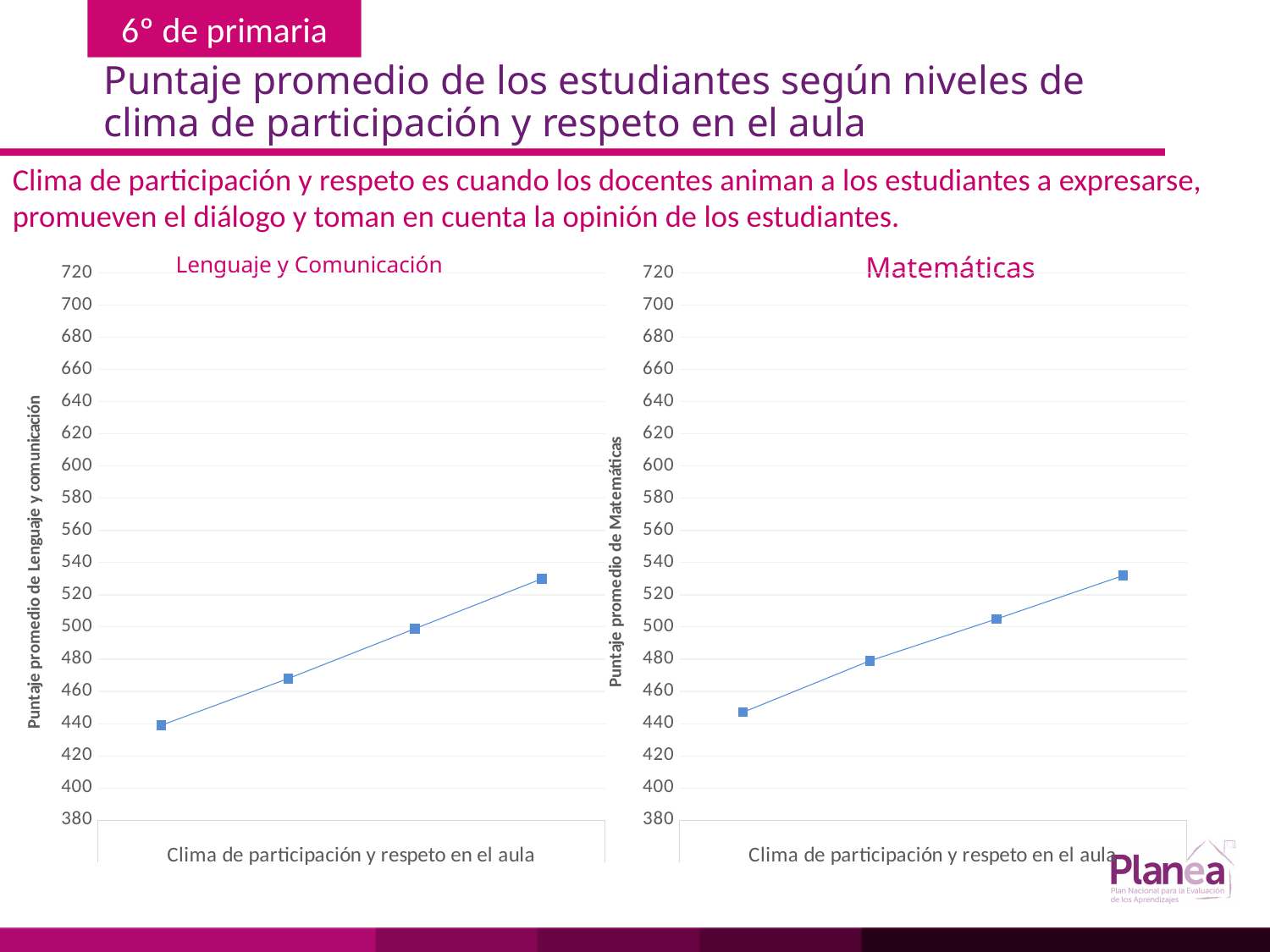
In the Matemáticas chart, is the value of the rightmost point greater or less than 520? greater In the Matemáticas chart, is the value of the leftmost point greater or less than 460? less How many data points are plotted in the Matemáticas chart? 4 In the Lenguaje y Comunicación chart, do the values rise or fall from left to right? rise In the Matemáticas chart, which point is higher: the leftmost or the rightmost? the rightmost What kind of chart is the Matemáticas chart on the right? line chart What is the y-axis label of the Matemáticas chart? Puntaje promedio de Matemáticas How many data points are plotted in the Lenguaje y Comunicación chart? 4 What kind of chart is the Lenguaje y Comunicación chart on the left? line chart In the Matemáticas chart, do the values rise or fall from left to right? rise In the Lenguaje y Comunicación chart, is the value of the rightmost point greater or less than 520? greater